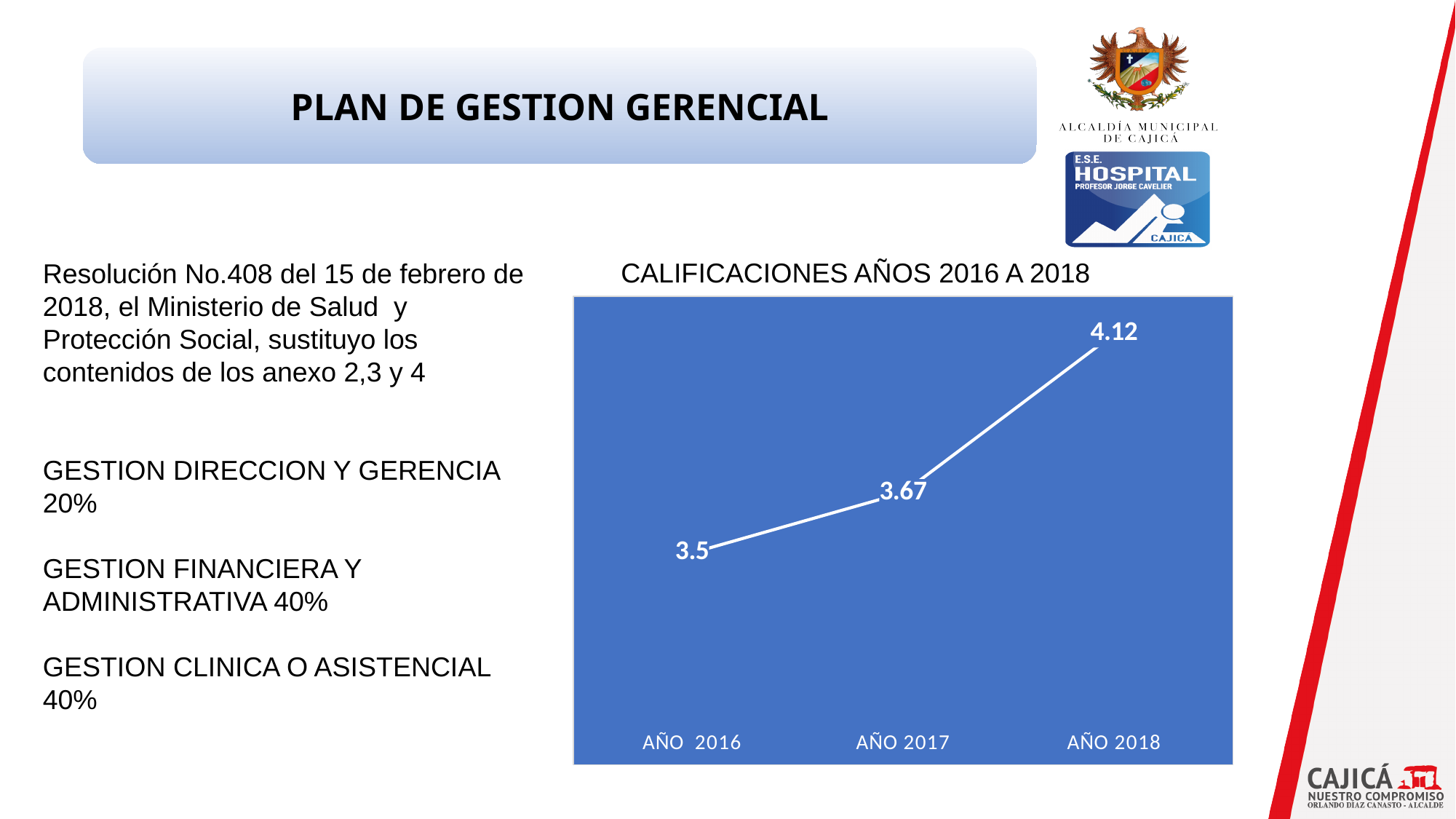
What is the value for AÑO 2016? 3.5 Which year has the lowest value? AÑO 2016 How many data points are plotted on the chart? 3 What kind of chart is shown? line chart What is the title of the chart? CALIFICACIONES AÑOS 2016 A 2018 Do the values rise or fall from AÑO 2016 to AÑO 2018? rise What is the value for AÑO 2017? 3.67 Which is larger, the value for AÑO 2016 or AÑO 2018? AÑO 2018 What is the value for AÑO 2018? 4.12 What is the difference between the values for AÑO 2017 and AÑO 2016? 0.17 Which year has the highest value? AÑO 2018 What is the difference between the values for AÑO 2018 and AÑO 2017? 0.45